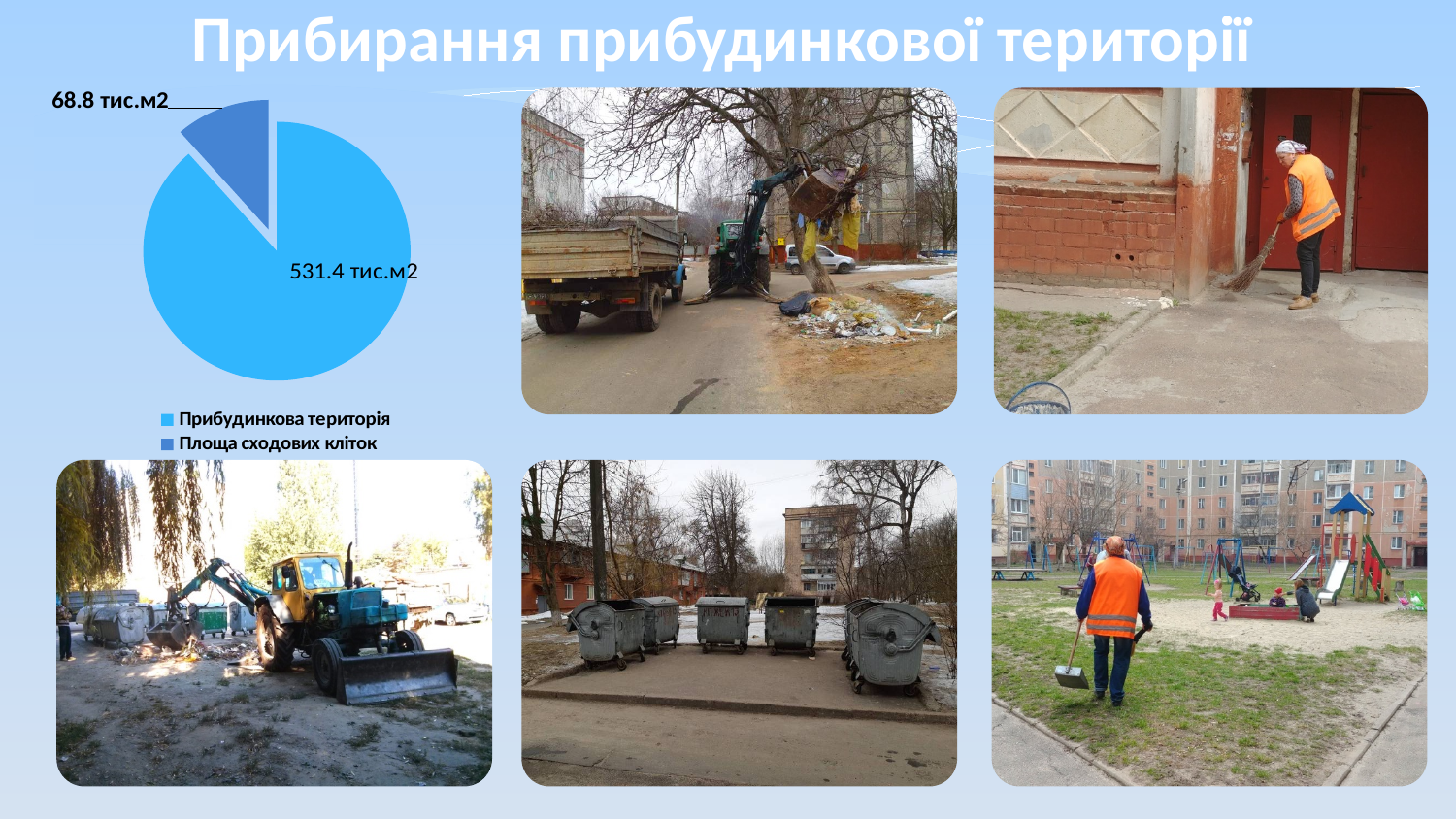
How many slices does the pie chart have? 2 Which is larger in the pie chart: Прибудинкова територія or Площа сходових кліток? Прибудинкова територія What is the value for Прибудинкова територія in the pie chart? 531.4 тис.м2 How many entries does the legend of the pie chart list? 2 Which category has the largest slice in the pie chart? Прибудинкова територія What is the difference between the values for Прибудинкова територія and Площа сходових кліток? 462.6 тис.м2 What is the total of the two values shown in the pie chart? 600.2 тис.м2 What kind of chart is shown on the slide? pie chart What is the title of the slide containing the pie chart? Прибирання прибудинкової території Which category has the smallest slice in the pie chart? Площа сходових кліток Which legend entry is shown in the darker blue colour in the pie chart? Площа сходових кліток What is the value for Площа сходових кліток in the pie chart? 68.8 тис.м2